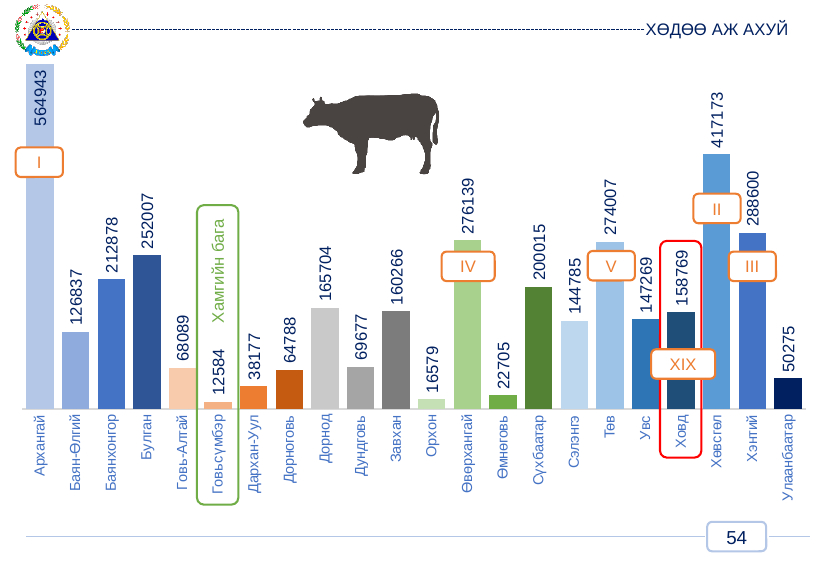
How many categories are shown on the chart? 22 What is the value shown for Ховд? 158769 What is the value shown for Архангай? 564943 What kind of chart is shown on the slide? Bar chart What is the value shown for Хөвсгөл? 417173 Which category has the highest value? Архангай What is the value shown for Говьсүмбэр? 12584 What is the difference between the values for Хөвсгөл and Хэнтий? 128573 Which category has the lowest value? Говьсүмбэр What is the difference between the values for Архангай and Хөвсгөл? 147770 Which is larger, the value for Өвөрхангай or the value for Төв? Өвөрхангай Which category is marked with the label 'Хамгийн бага' on the chart? Говьсүмбэр